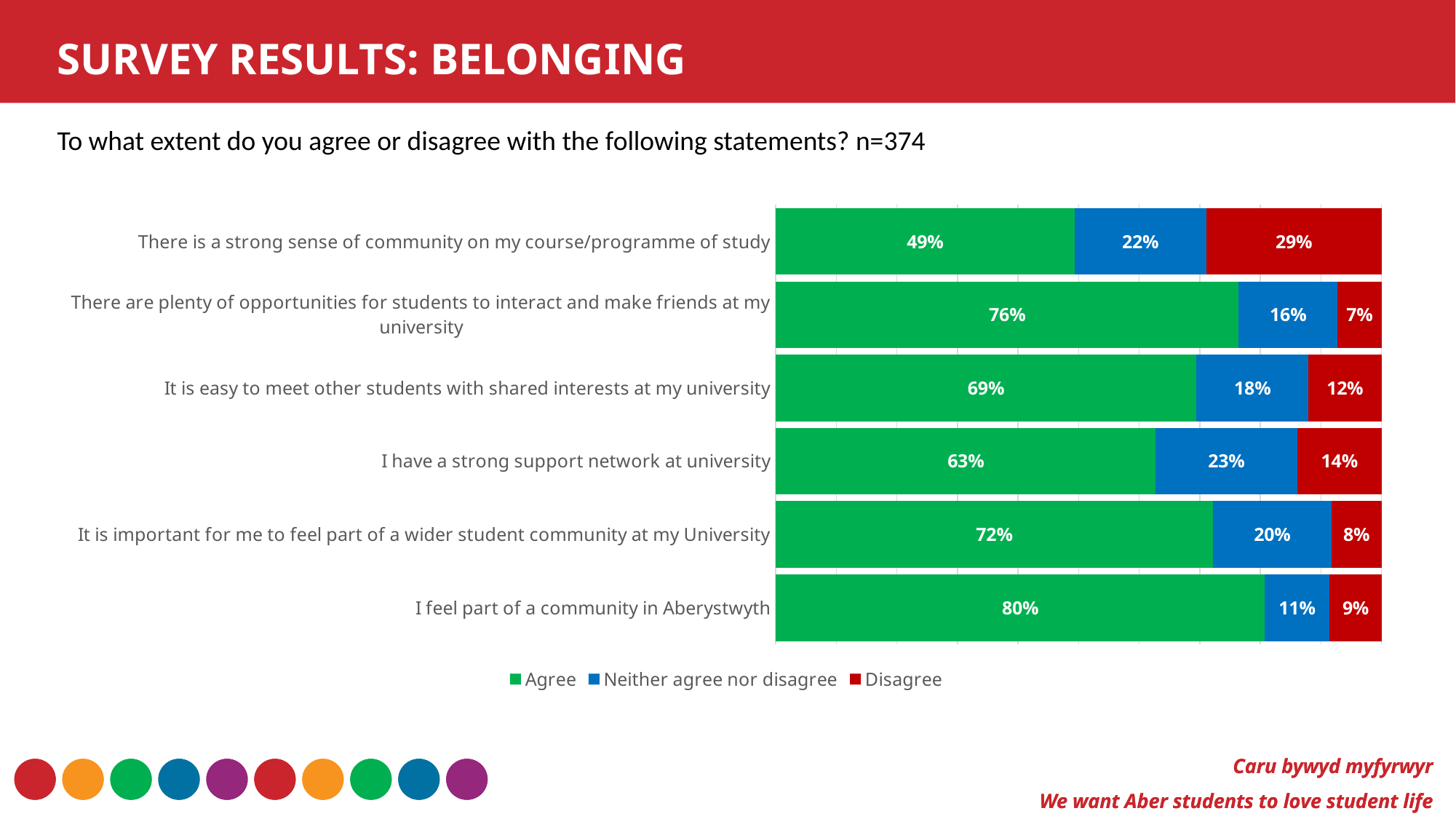
What percentage neither agree nor disagree that it is easy to meet other students with shared interests at their university? 18% Which is larger: the Disagree percentage for 'It is easy to meet other students with shared interests at my university' or for 'I feel part of a community in Aberystwyth'? It is easy to meet other students with shared interests at my university Which statement has the lowest Agree percentage? There is a strong sense of community on my course/programme of study What is the difference between the Agree percentages for 'I feel part of a community in Aberystwyth' and 'There is a strong sense of community on my course/programme of study'? 31% What percentage of respondents agree that there is a strong sense of community on their course/programme of study? 49% What percentage of respondents disagree with the statement 'I have a strong support network at university'? 14% How many statements are shown in the chart? 6 Which colour represents the Disagree series in the chart? Red Which statement has the highest Disagree percentage? There is a strong sense of community on my course/programme of study How many series does the legend list? 3 Which statement has the highest Agree percentage? I feel part of a community in Aberystwyth What kind of chart is shown on the slide? Stacked bar chart